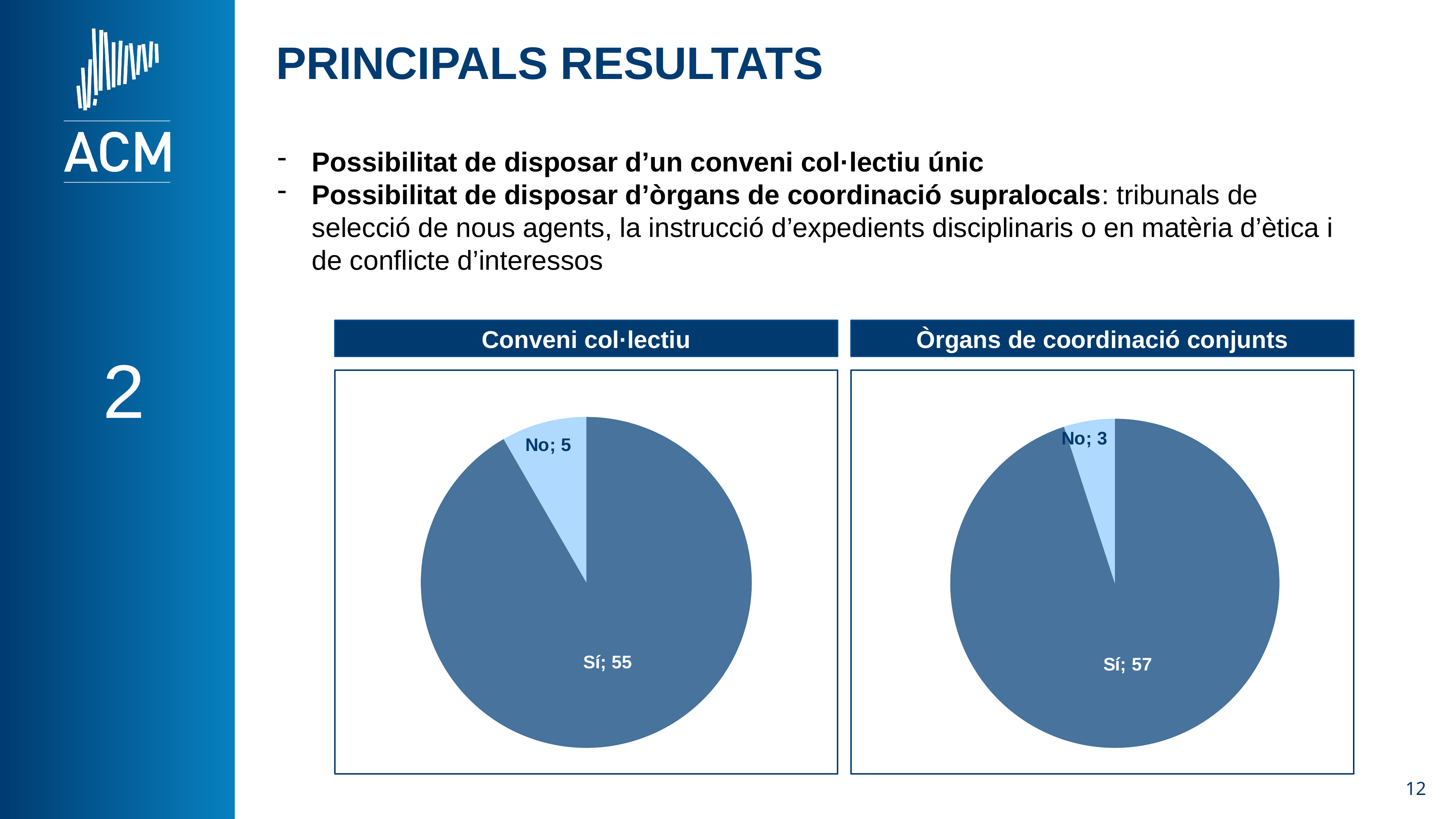
In the 'Òrgans de coordinació conjunts' chart, what is the difference between the 'Sí' and 'No' values? 54 In the 'Conveni col·lectiu' chart, what is the value for 'Sí'? 55 In the 'Òrgans de coordinació conjunts' chart, what is the value for 'No'? 3 What type of chart is used for 'Òrgans de coordinació conjunts'? Pie chart In the 'Òrgans de coordinació conjunts' chart, which category has the smallest slice? No Is the 'No' value larger in the 'Conveni col·lectiu' chart or in the 'Òrgans de coordinació conjunts' chart? Conveni col·lectiu What is the title of the chart on the right side of the slide? Òrgans de coordinació conjunts In the 'Conveni col·lectiu' chart, which category has the largest slice? Sí How many slices does the 'Conveni col·lectiu' pie chart have? 2 In the 'Conveni col·lectiu' chart, what is the value for 'No'? 5 In the 'Conveni col·lectiu' chart, what is the difference between the 'Sí' and 'No' values? 50 In the 'Òrgans de coordinació conjunts' chart, what is the value for 'Sí'? 57